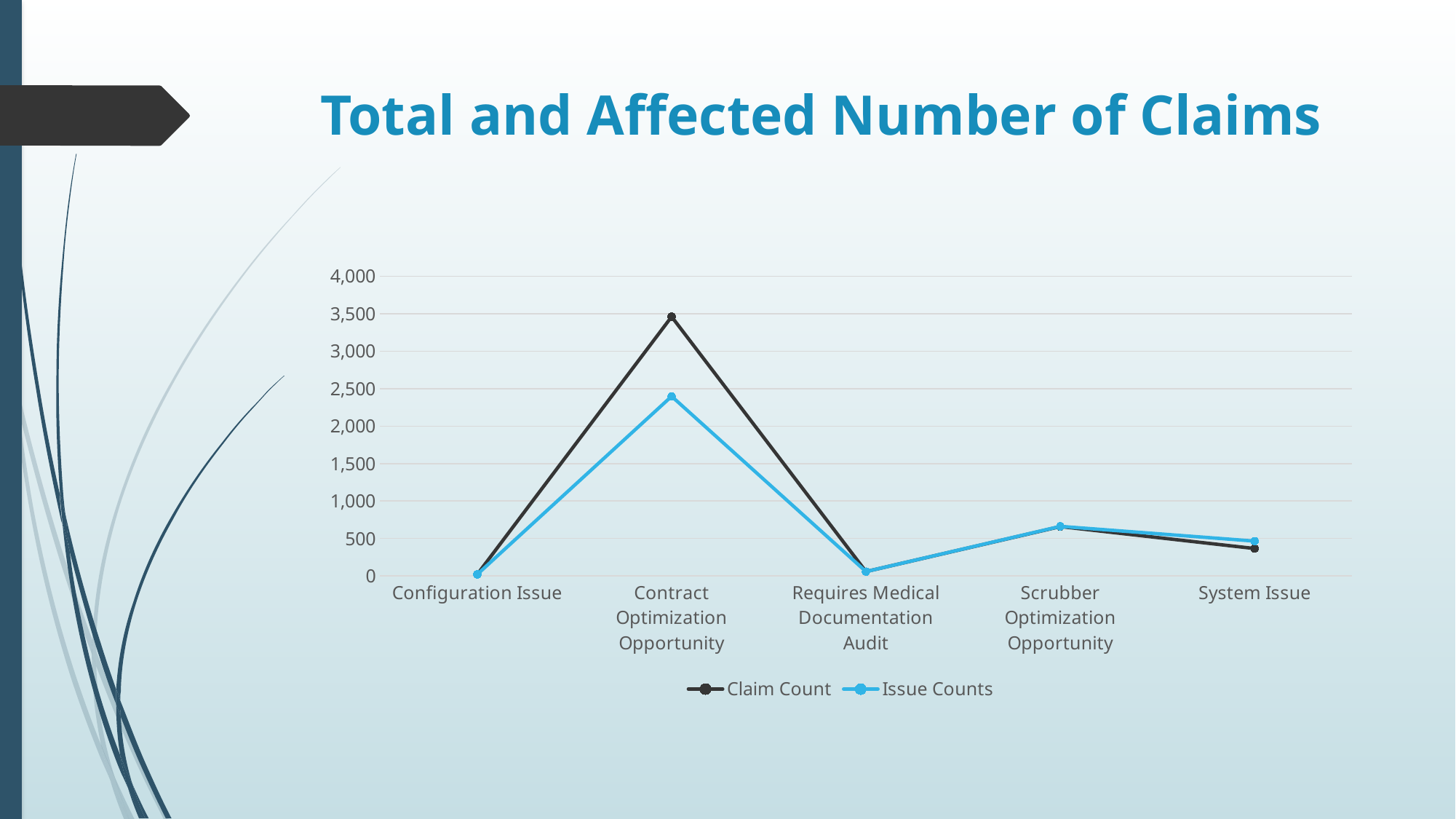
Is the Issue Counts value for Contract Optimization Opportunity greater or less than 3,000? less What kind of chart is shown on the slide? line chart Does the Claim Count rise or fall from Contract Optimization Opportunity to Requires Medical Documentation Audit? fall For Contract Optimization Opportunity, which is larger: Claim Count or Issue Counts? Claim Count Which category has the highest Issue Counts value? Contract Optimization Opportunity Is the Claim Count for Scrubber Optimization Opportunity greater or less than 500? greater How many series does the legend list? 2 Is the Claim Count for System Issue greater or less than 500? less What is the title of the chart on the slide? Total and Affected Number of Claims Which category has the highest Claim Count? Contract Optimization Opportunity How many categories are shown on the x axis? 5